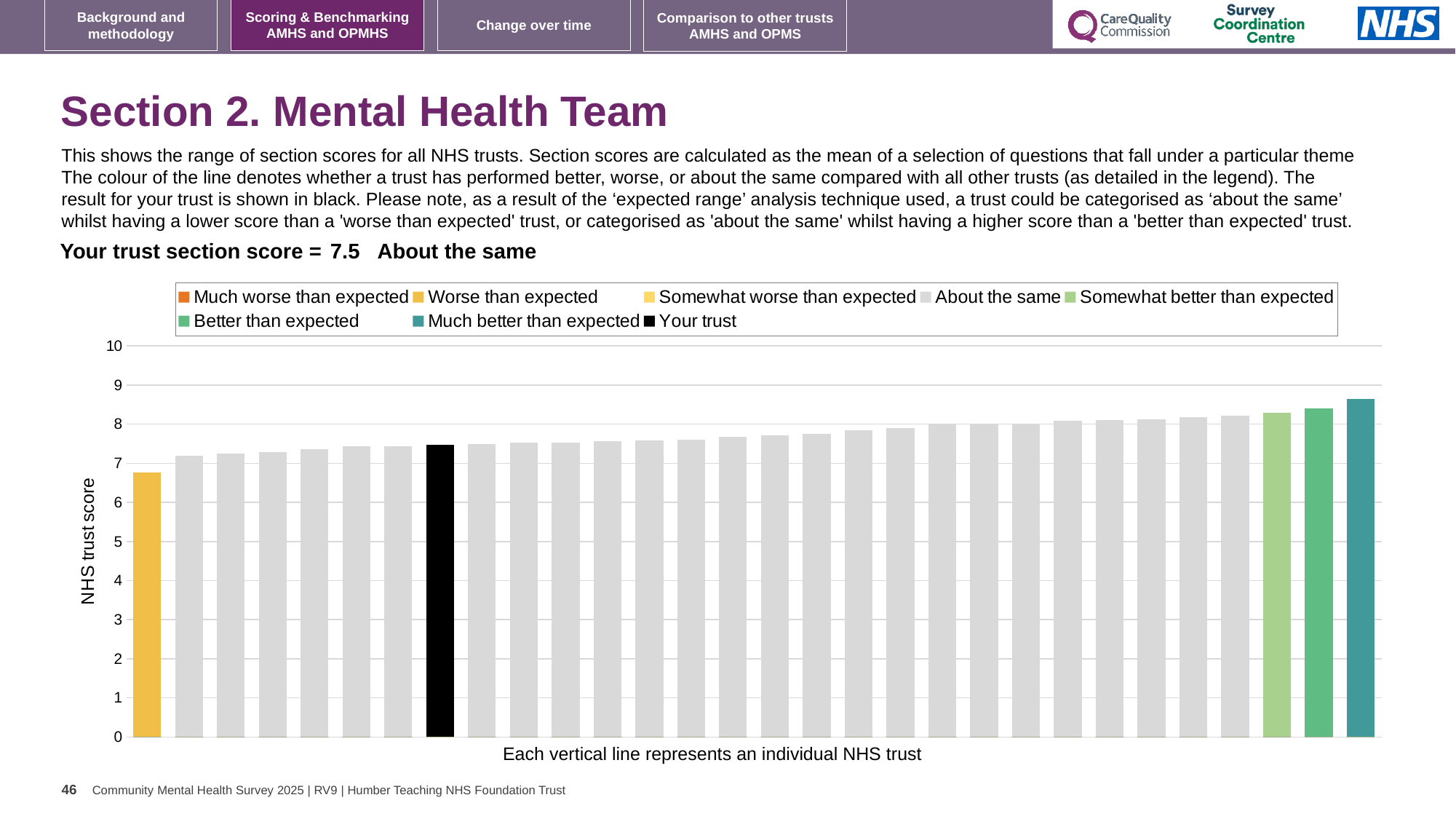
Do the bar values rise or fall from left to right across the chart? rise Which category is your trust placed in for this section? About the same How many entries does the chart legend list? 8 Is the value of the rightmost bar greater or less than 8? greater What is the label on the vertical axis? NHS trust score What is the section score for your trust? 7.5 What colour is the bar for your trust? black What kind of chart is shown on the slide? bar chart Is the 'Worse than expected' bar higher or lower than your trust's bar? lower Is the value of the leftmost (yellow) bar greater or less than 7? less Is the value of your trust's bar greater or less than 7? greater Which legend category does the highest bar belong to? Much better than expected